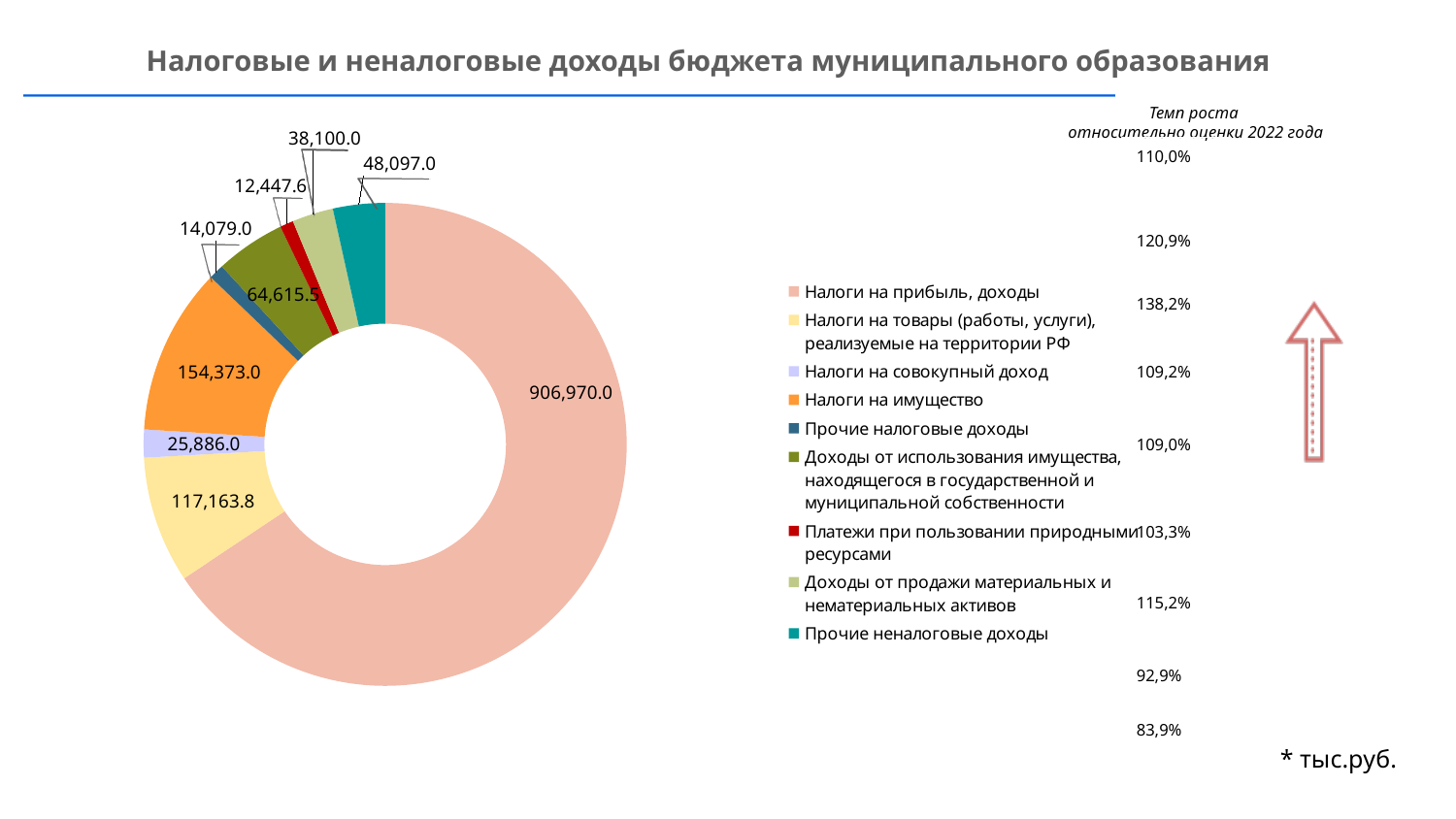
What is the value for Налоги на прибыль, доходы? 906,970.0 What is the value for Доходы от использования имущества, находящегося в государственной и муниципальной собственности? 64,615.5 Which is larger: Прочие неналоговые доходы or Доходы от продажи материальных и нематериальных активов? Прочие неналоговые доходы Which category has the largest value? Налоги на прибыль, доходы What type of chart is shown on the slide? Pie (doughnut) chart Which category has the smallest value? Платежи при пользовании природными ресурсами What is the value for Налоги на имущество? 154,373.0 How many categories does the legend list? 9 What is the difference between the values for Налоги на имущество and Налоги на товары (работы, услуги), реализуемые на территории РФ? 37,209.2 What is the value for Налоги на совокупный доход? 25,886.0 What is the value for Прочие неналоговые доходы? 48,097.0 What colour is the slice for Налоги на имущество? Orange